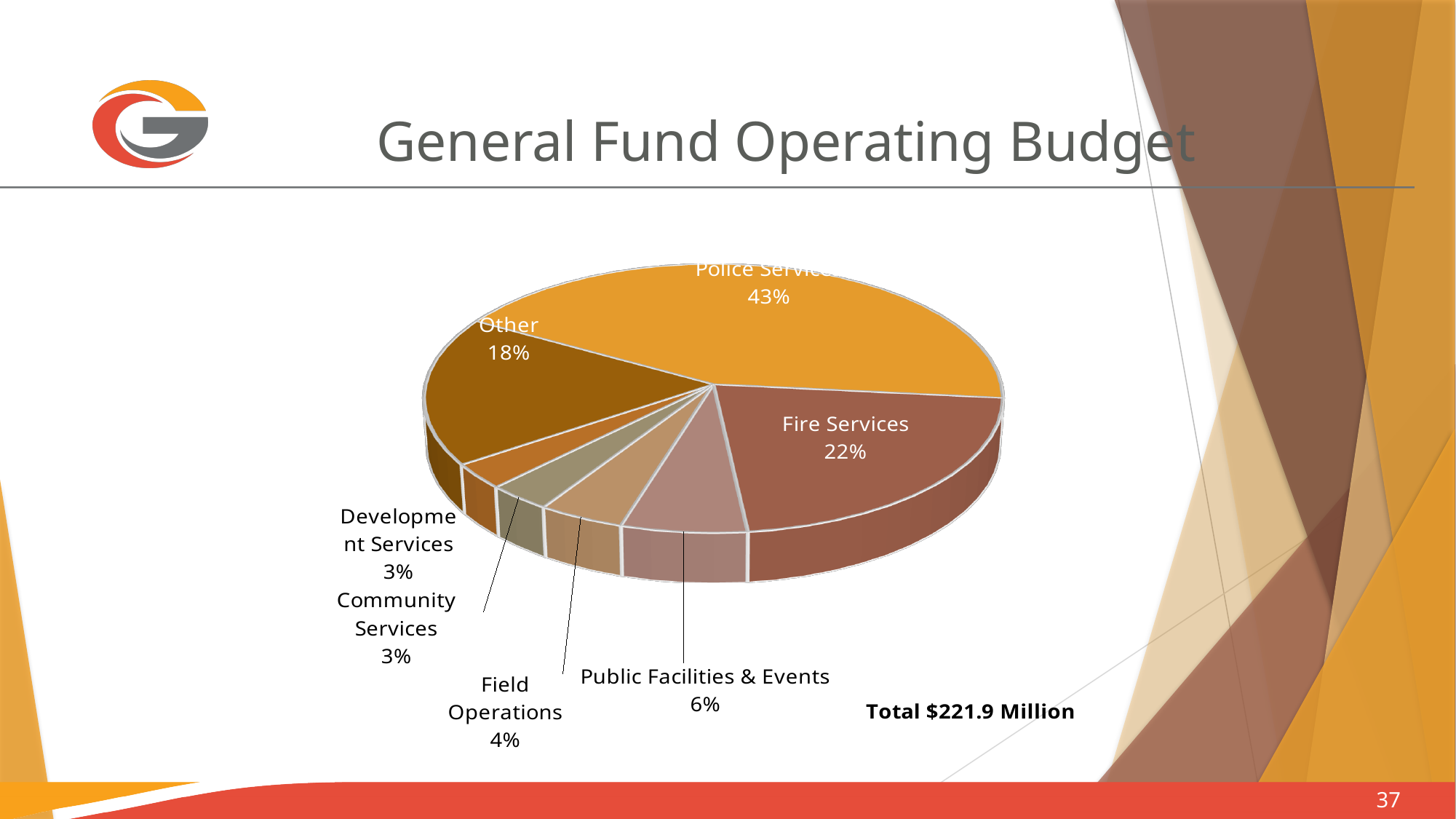
What percentage of the pie is Fire Services? 22% Which category has the largest slice of the pie? Police Services What kind of chart is shown on the slide? Pie chart How many slices does the pie chart have? 7 What is the difference in percentage points between Police Services and Fire Services? 21 percentage points What percentage is shown for Public Facilities & Events? 6% What share of the General Fund Operating Budget goes to Police Services? 43% What share does the Other slice represent? 18% What is the total budget amount stated on the slide? $221.9 Million What percentage is shown for Field Operations? 4% What is the title of the slide containing the pie chart? General Fund Operating Budget Which is larger, the Other slice or the Fire Services slice? Fire Services